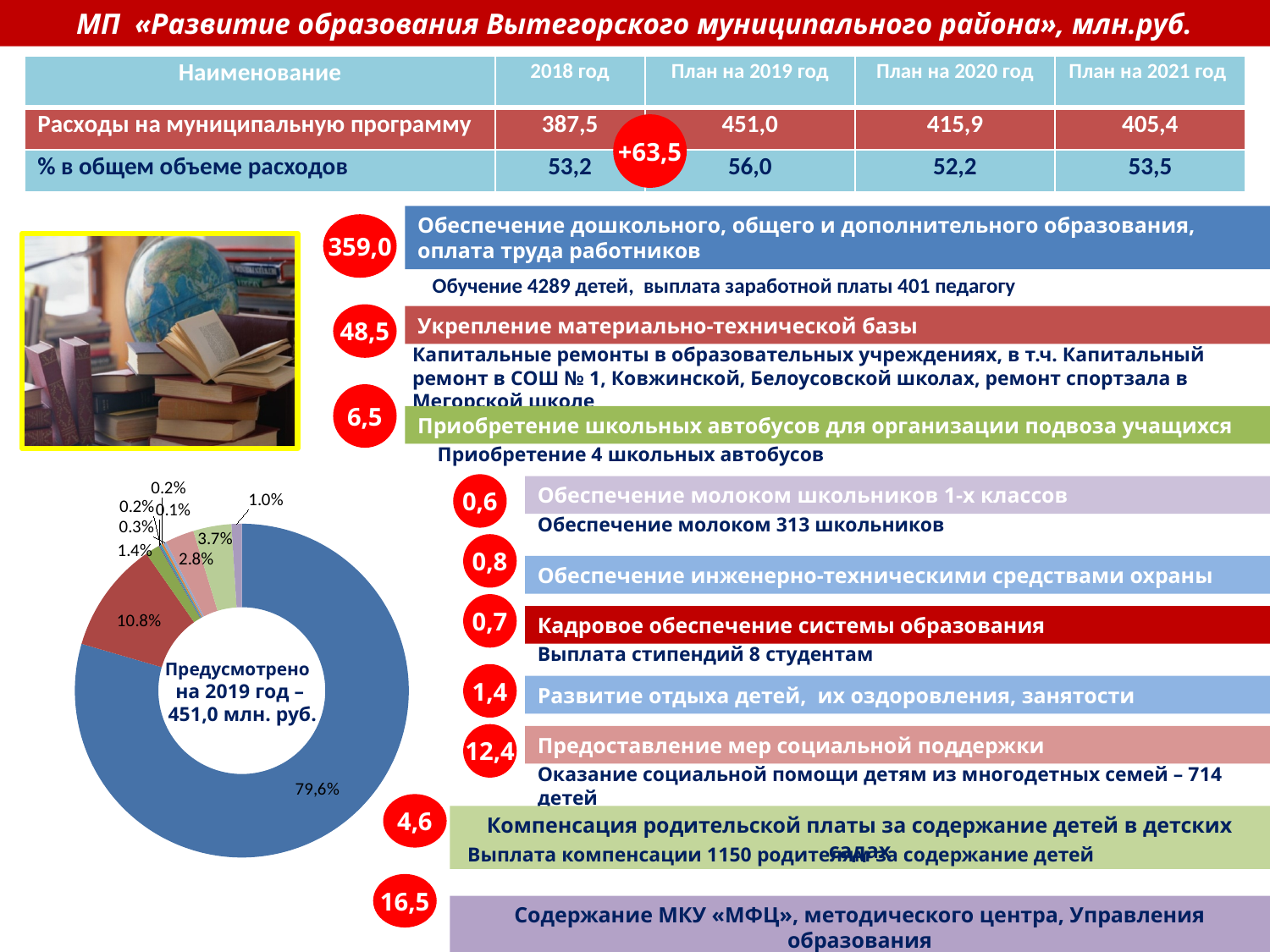
How many slices does the pie chart have? 10 What is the value of the smallest slice in the pie chart? 0.1% What is the difference between the largest slice (79,6%) and the second-largest slice (10.8%) in the pie chart? 68,8% What is the value of the largest slice in the pie chart? 79,6% What kind of chart is shown on the left of the slide? pie chart (doughnut) What text is written in the centre of the pie chart? Предусмотрено на 2019 год – 451,0 млн. руб. What total amount for 2019 is stated in the centre of the pie chart? 451,0 млн. руб. What is the value of the second-largest slice in the pie chart? 10.8% Does the pie chart display a legend with category names? No